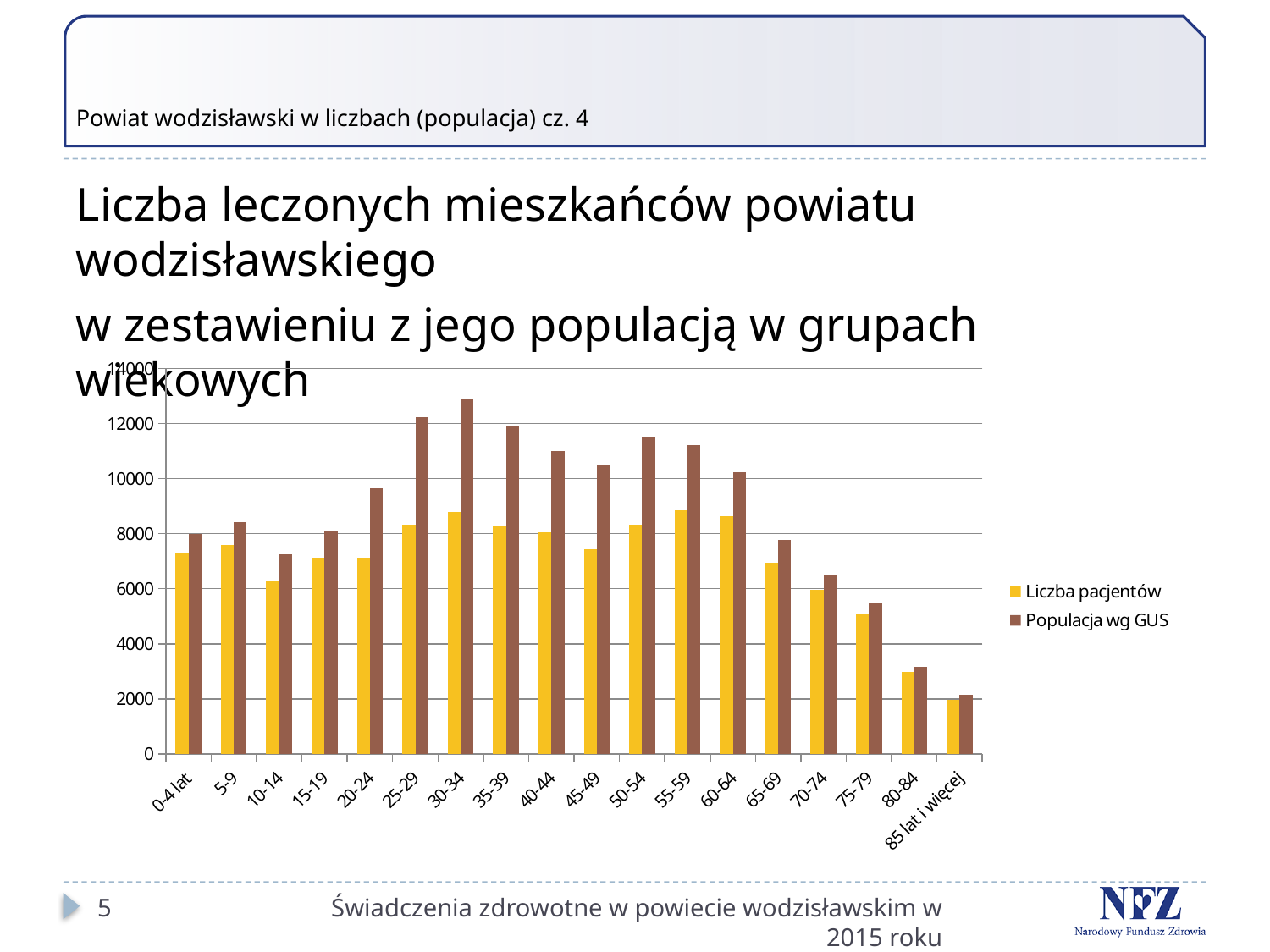
What kind of chart is shown on the slide? bar chart Is the value of Populacja wg GUS for 20-24 greater or less than 10000? less Is the value of Liczba pacjentów for 45-49 greater or less than 8000? less Is the value of Populacja wg GUS for 65-69 greater or less than 8000? less How many age groups are shown on the x axis? 18 Does the Populacja wg GUS series rise or fall from 30-34 to 85 lat i więcej? fall Which age group has the lowest value for Populacja wg GUS? 85 lat i więcej Which is larger for Populacja wg GUS: 40-44 or 45-49? 40-44 How many series does the legend list? 2 Which age group has the lowest value for Liczba pacjentów? 85 lat i więcej Which age group has the highest value for Populacja wg GUS? 30-34